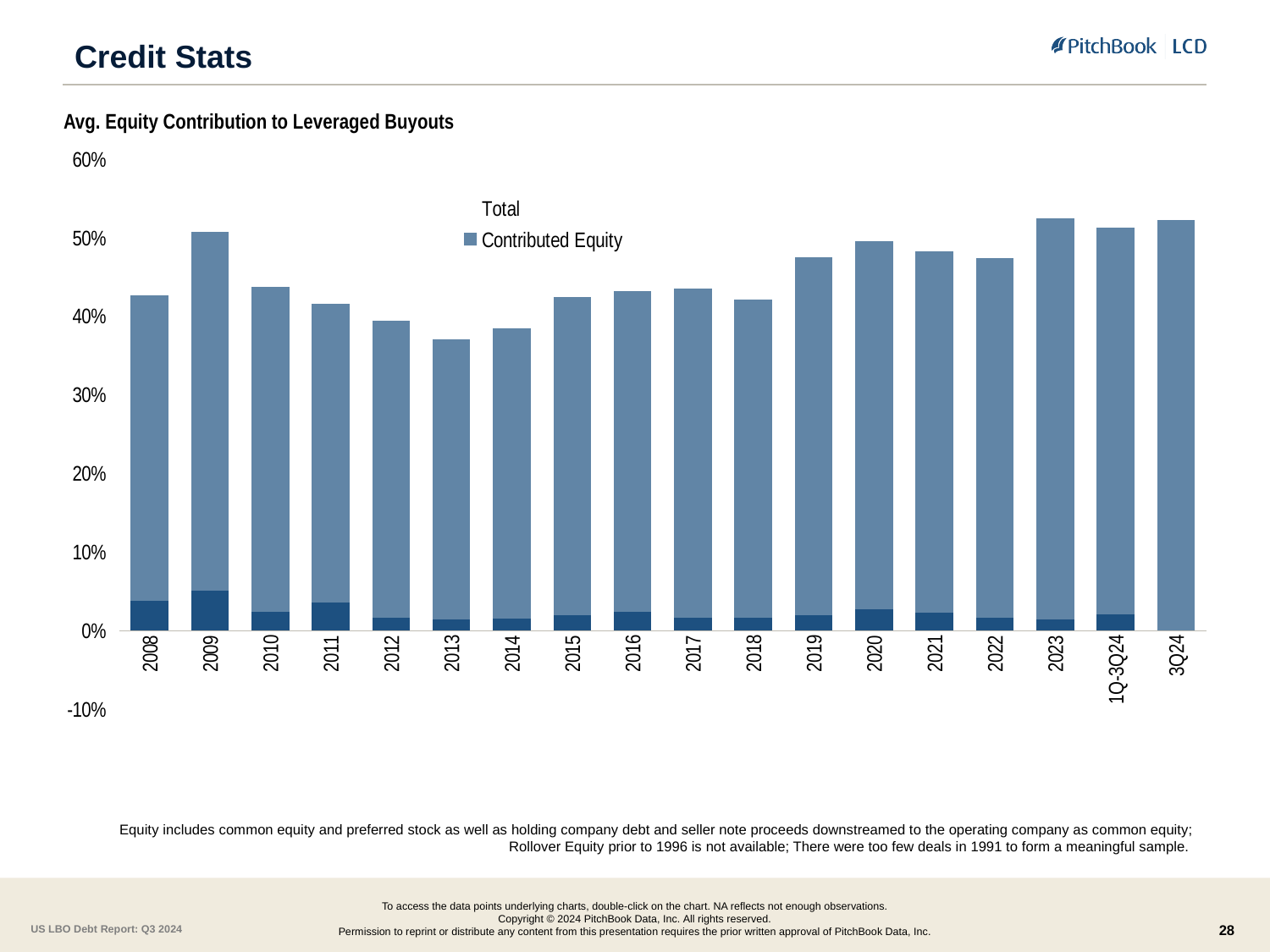
Which year has the lowest total bar in the chart? 2013 What type of chart is shown on the slide? Bar chart Is the total value for 2023 greater or less than 50%? greater Do the total bars generally rise or fall from 2013 to 2020? Rise Which has the larger total bar, 2020 or 2016? 2020 Which has the larger total bar, 2009 or 2013? 2009 How many series does the chart legend list? 2 Is the total value for 2013 greater or less than 40%? less How many categories are shown along the x axis of the chart? 18 What is the title of the chart? Avg. Equity Contribution to Leveraged Buyouts Is the total value for 2019 greater or less than 50%? less